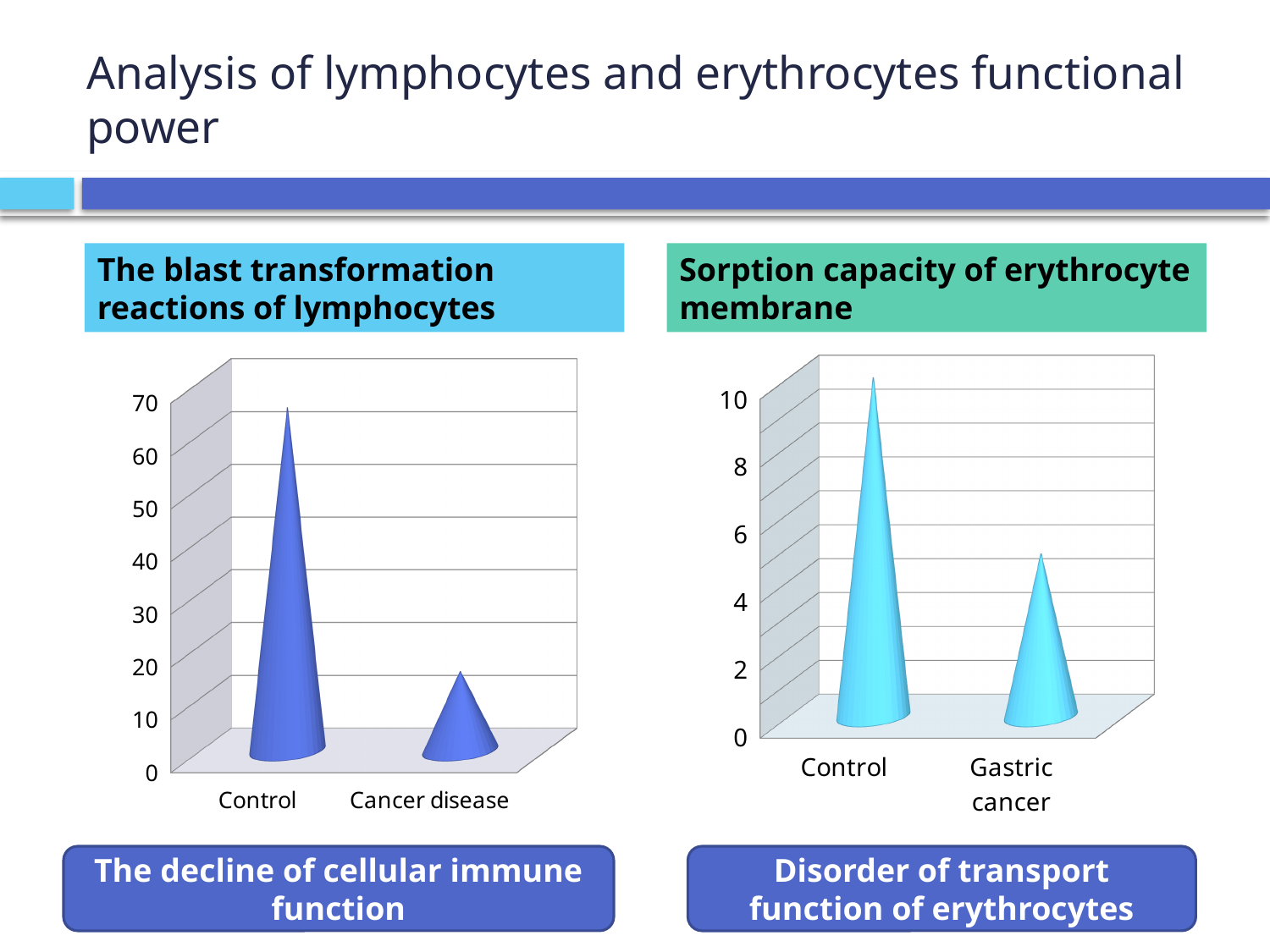
How many categories are shown in the left chart 'The blast transformation reactions of lymphocytes'? 2 What is the title of the chart on the left side of the slide? The blast transformation reactions of lymphocytes In the left chart 'The blast transformation reactions of lymphocytes', which category has the lowest value? Cancer disease What type of chart is used in the left chart titled 'The blast transformation reactions of lymphocytes'? bar chart In the right chart 'Sorption capacity of erythrocyte membrane', is the value for Control greater or less than 6? greater In the left chart 'The blast transformation reactions of lymphocytes', is the value for Cancer disease greater or less than 30? less In the right chart 'Sorption capacity of erythrocyte membrane', is the value for Gastric cancer greater or less than 8? less What is the highest value shown on the vertical axis of the right chart 'Sorption capacity of erythrocyte membrane'? 10 In the left chart 'The blast transformation reactions of lymphocytes', which category has the highest value? Control How many categories are shown in the right chart 'Sorption capacity of erythrocyte membrane'? 2 In the right chart 'Sorption capacity of erythrocyte membrane', which category has the higher value, Control or Gastric cancer? Control